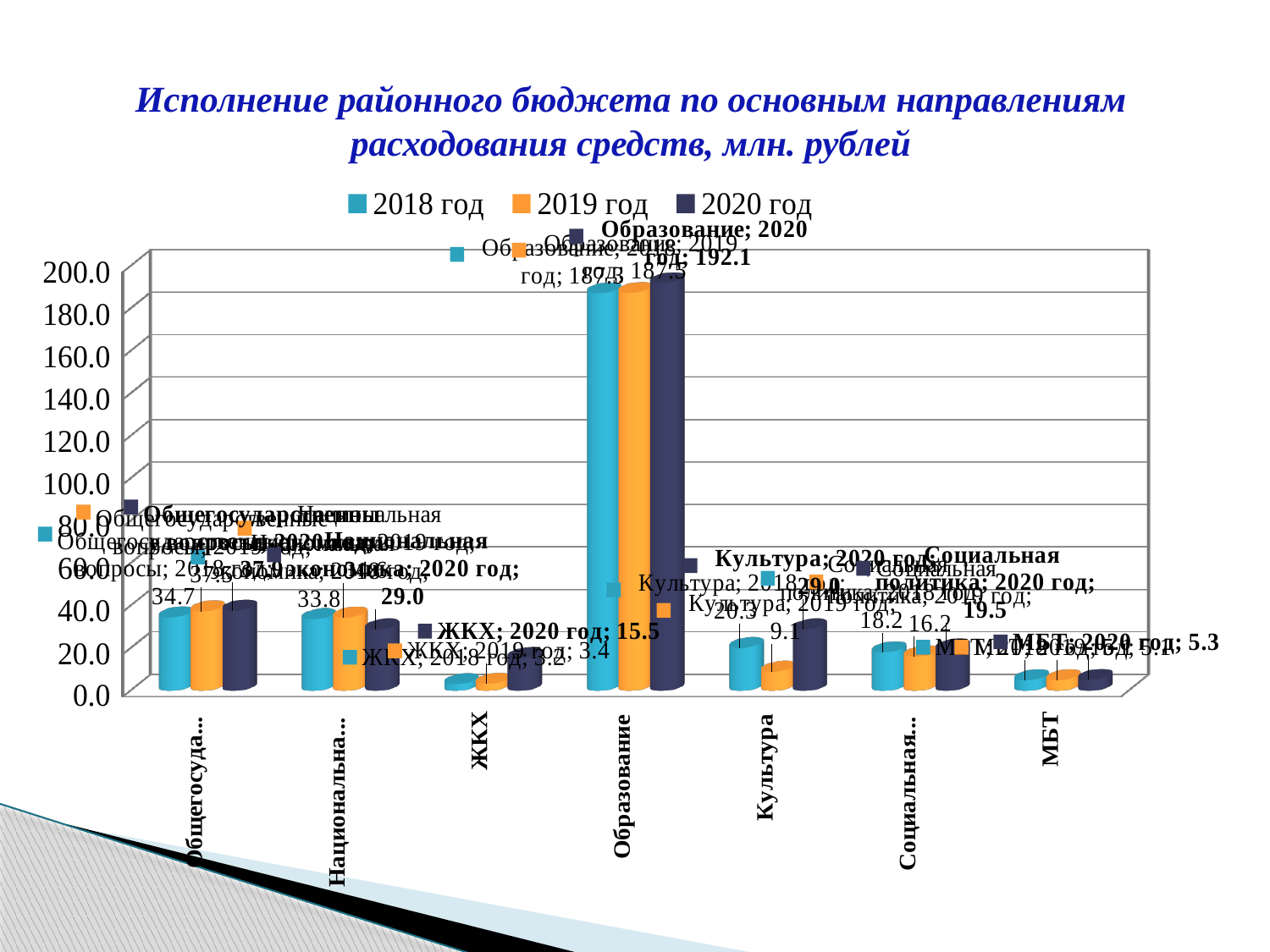
What kind of chart is shown on the slide? bar chart What is the value for Образование in 2020 год? 192.1 Is the value for Образование in 2018 год greater or less than 160? greater Which category has the lowest values in the chart? МБТ How many series does the legend list? 3 What is the difference between the ЖКХ values for 2020 год (15.5) and 2019 год (3.4)? 12.1 What is the value for МБТ in 2020 год? 5.3 Which is larger for Культура: the 2020 год value or the 2019 год value? 2020 год What is the value for Культура in 2019 год? 9.1 Which category has the highest values in the chart? Образование How many categories are shown on the x axis? 7 What is the value for ЖКХ in 2020 год? 15.5